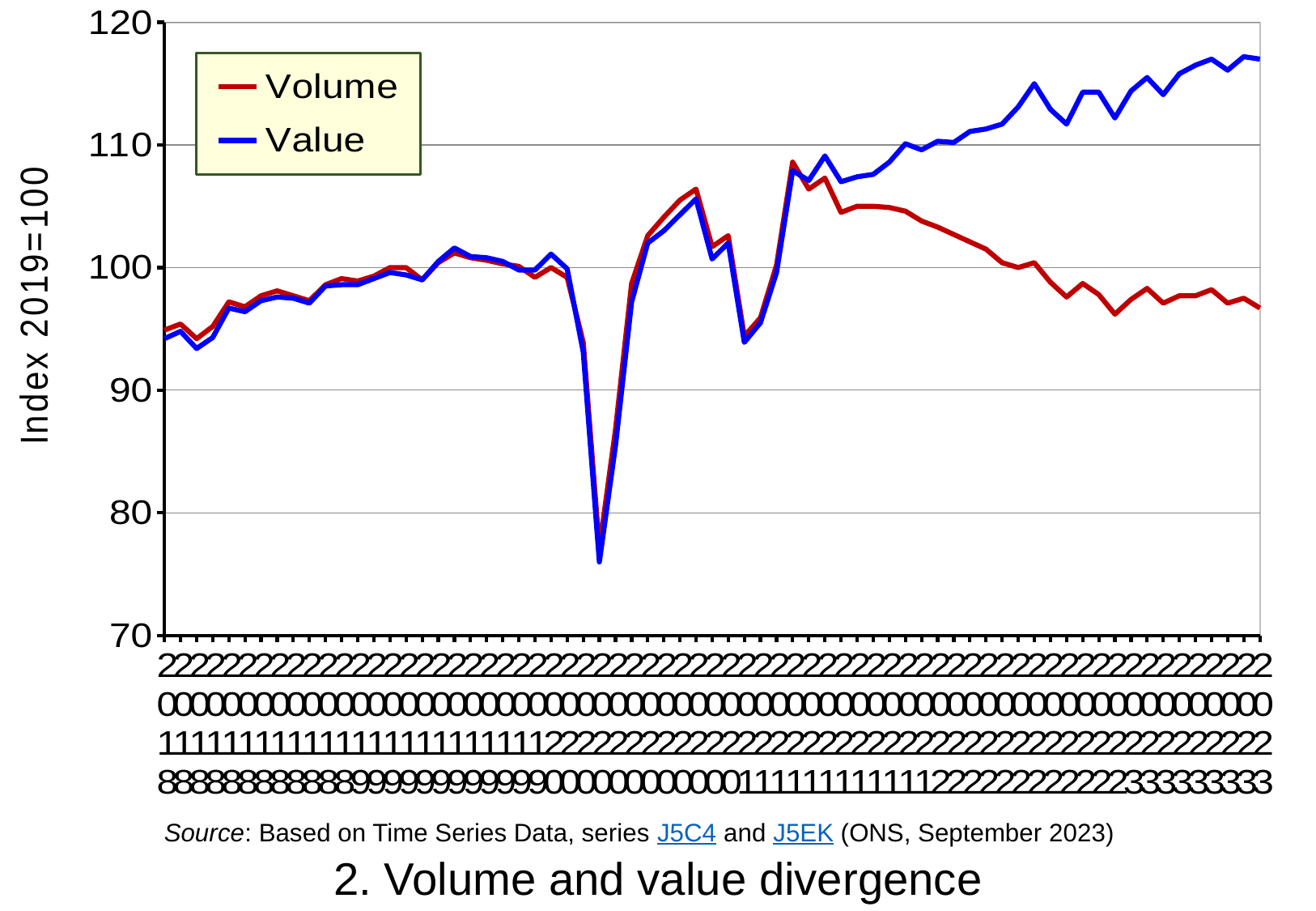
What is the title of the chart? 2. Volume and value divergence Over the final section of the chart (2022 to 2023), does the Volume line rise or fall? fall Is the last plotted value of the Volume line greater or less than 100? less Is the lowest point of the Value line greater or less than 80? less Is the highest point of the Value line greater or less than 110? greater How many series does the legend list? 2 What is the label on the vertical axis? Index 2019=100 What kind of chart is shown on the slide? line chart At the right-hand end of the chart, which series is higher, Volume or Value? Value Over the final section of the chart (2022 to 2023), does the Value line rise or fall? rise